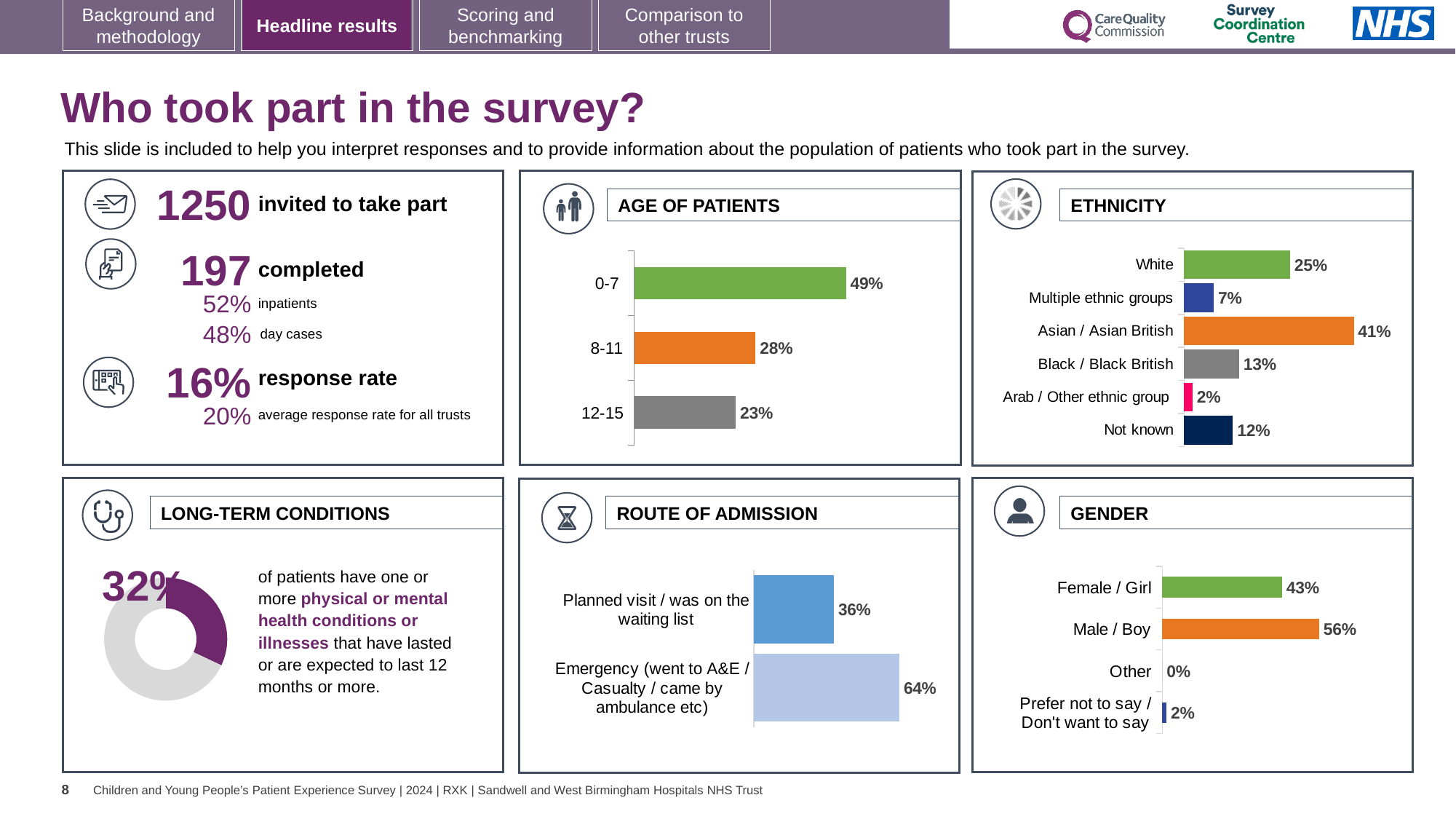
In the ROUTE OF ADMISSION chart, what percentage of patients came via Emergency (went to A&E / Casualty / came by ambulance etc)? 64% In the AGE OF PATIENTS chart, what percentage of patients were aged 0-7? 49% In the ETHNICITY chart, how many ethnicity categories are shown? 6 In the ETHNICITY chart, which is larger: White or Not known? White What type of chart is used in the LONG-TERM CONDITIONS panel? Doughnut chart In the ROUTE OF ADMISSION chart, what is the difference between the Emergency and Planned visit percentages? 28% In the GENDER chart, which category has the lowest percentage? Other In the ETHNICITY chart, what percentage of patients were Black / Black British? 13% In the AGE OF PATIENTS chart, which age group has the lowest percentage? 12-15 In the ETHNICITY chart, which ethnic group has the highest percentage? Asian / Asian British In the AGE OF PATIENTS chart, what is the difference between the 0-7 and 8-11 percentages? 21% In the GENDER chart, what percentage of patients were Male / Boy? 56%